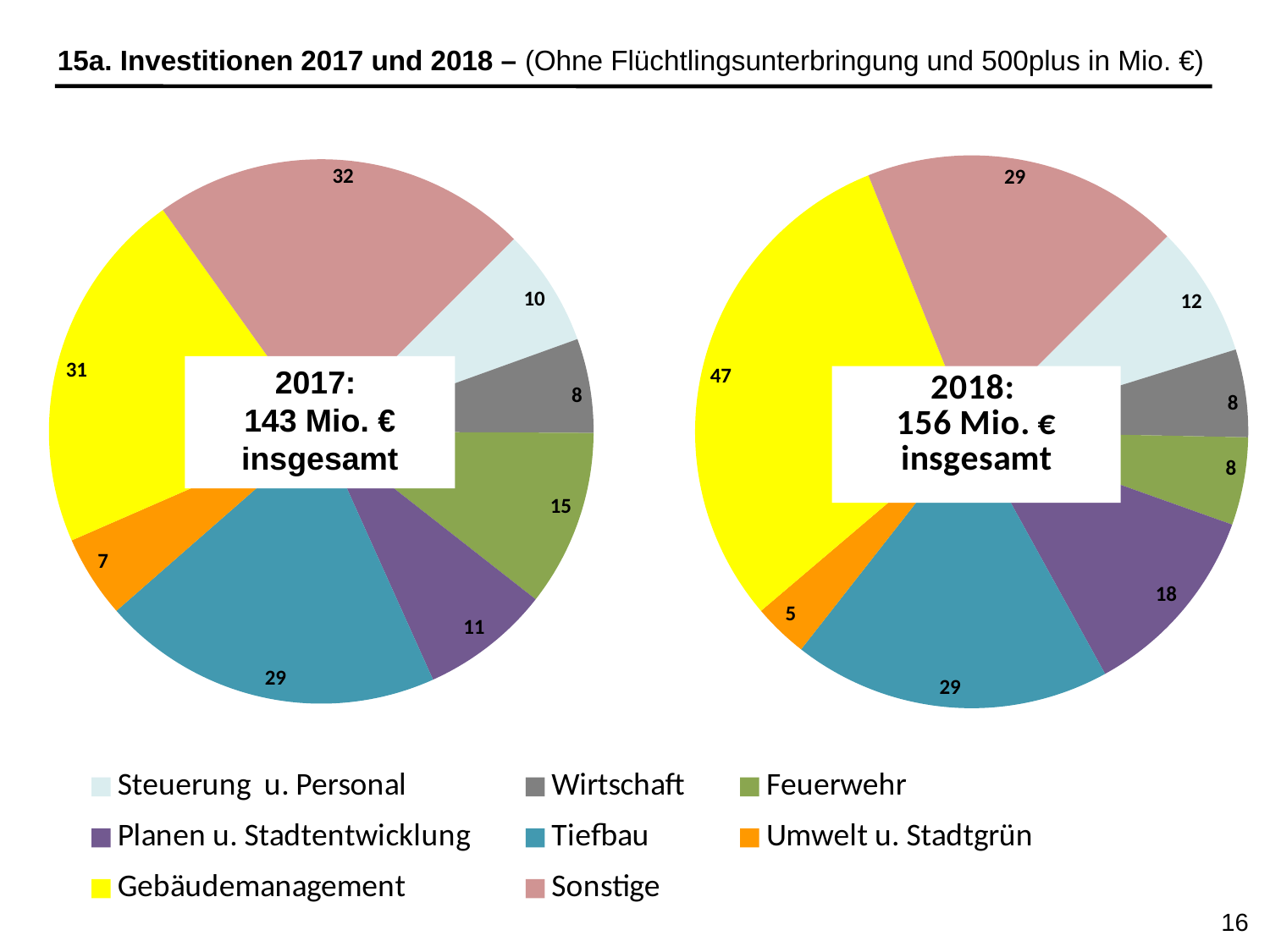
What total is printed in the centre of the 2018 pie chart? 156 Mio. € What is the difference between the Gebäudemanagement values in the 2018 and 2017 pie charts? 16 In the 2018 pie chart, which category has the smallest slice? Umwelt u. Stadtgrün How many categories does each pie chart show? 8 In the 2018 pie chart, what is the value for Gebäudemanagement? 47 What type of charts are shown on the slide? Pie charts In the 2017 pie chart, which is larger: Sonstige or Gebäudemanagement? Sonstige In the 2017 pie chart, which category has the smallest slice? Umwelt u. Stadtgrün In the 2017 pie chart, what is the value for Tiefbau? 29 Which colour represents Tiefbau in the legend? Teal blue In the 2018 pie chart, which category has the largest slice? Gebäudemanagement In the 2017 pie chart, what is the value for Feuerwehr? 15